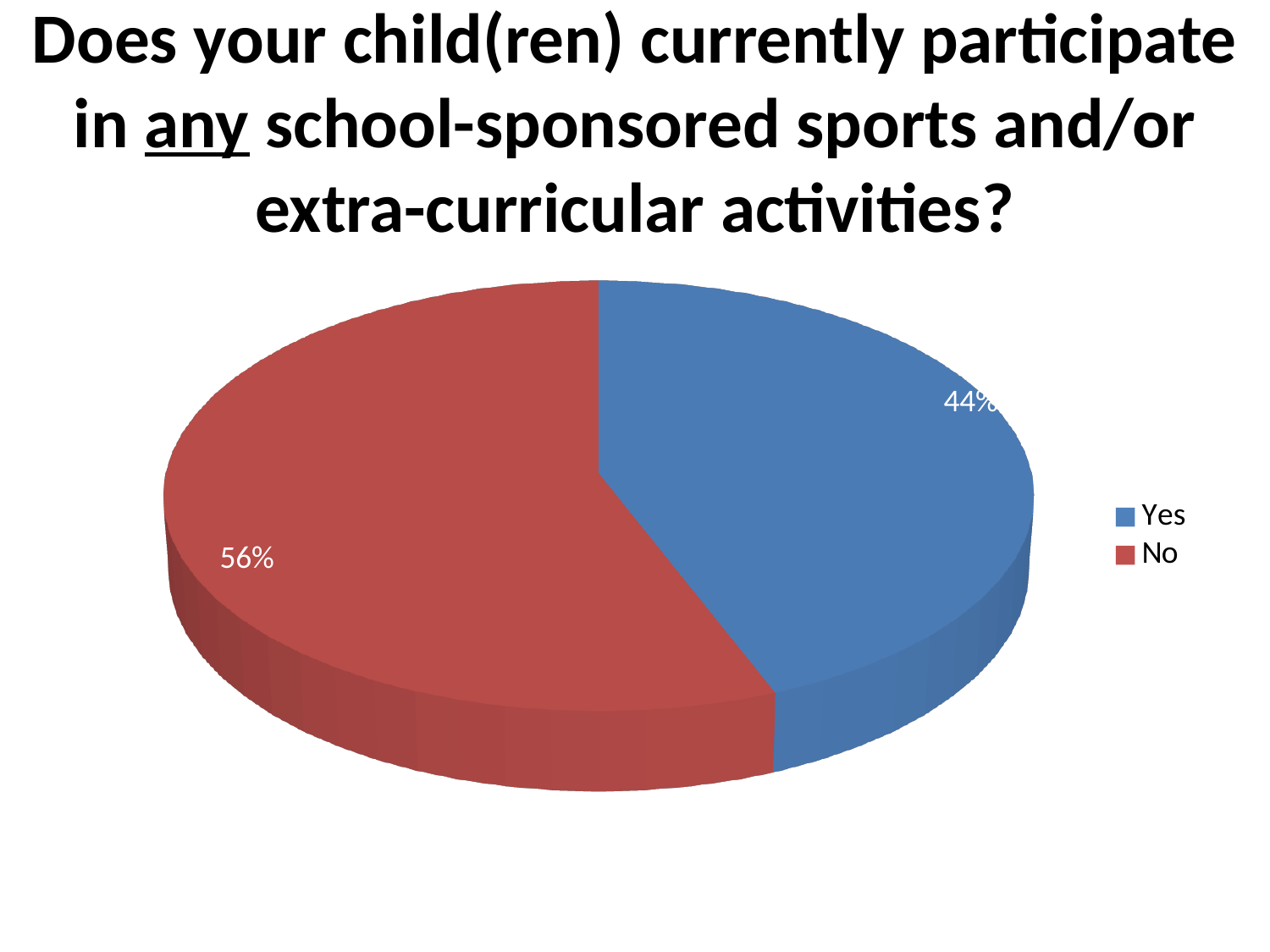
What kind of chart is shown on the slide? pie chart Is the "Yes" slice larger or smaller than the "No" slice? smaller What percentage of respondents answered "Yes"? 44% Which response has the larger share of the pie? No What colour is the "Yes" slice? blue What is the difference in percentage points between the "No" and "Yes" slices? 12 What share of the pie does the "No" slice represent? 56% How many entries does the legend list? 2 What colour is the "No" slice? red How many slices does the pie chart have? 2 What percentage of respondents answered "No"? 56% Which response has the smaller share of the pie? Yes